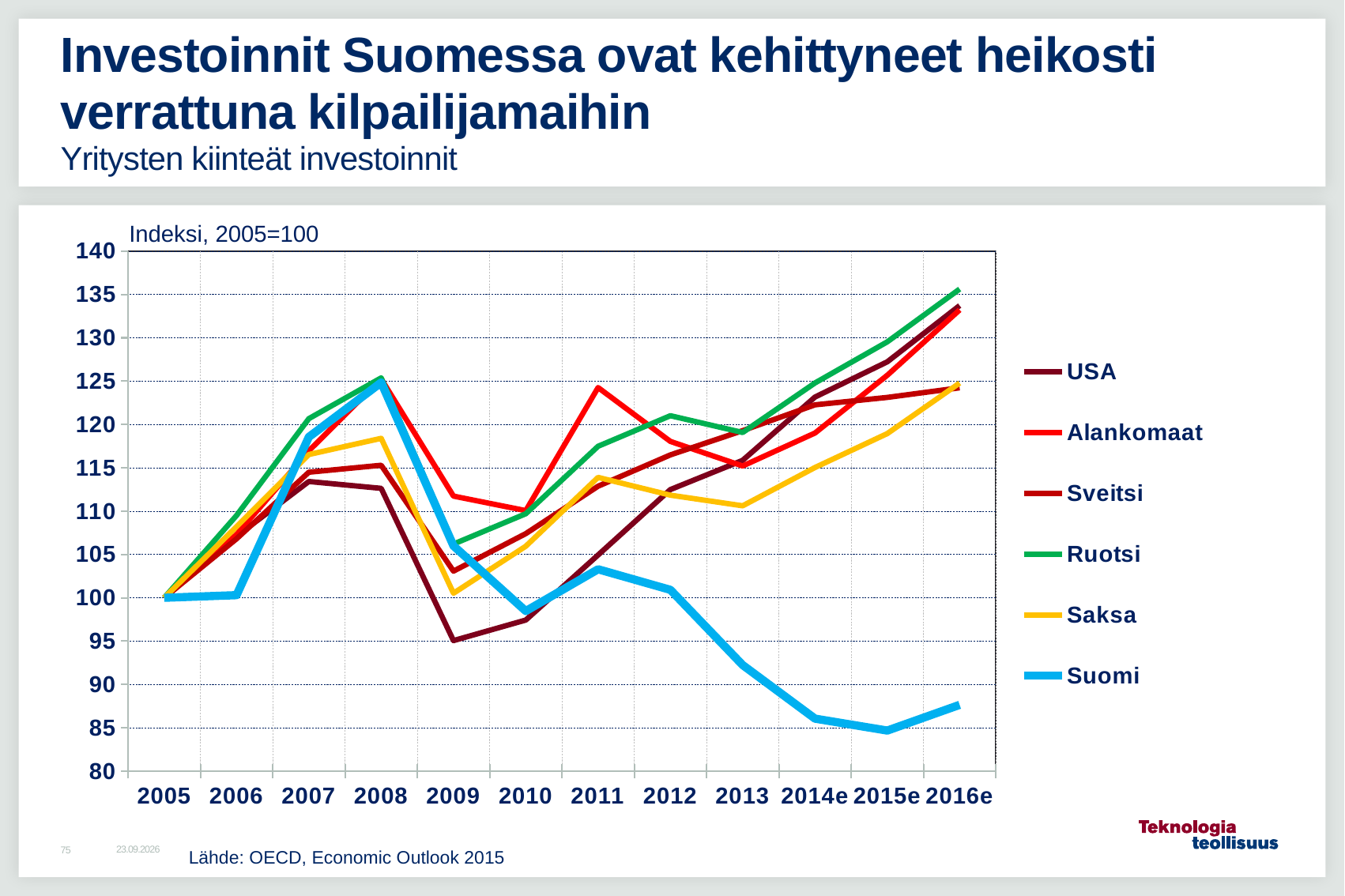
Which country has the highest index value in 2011? Alankomaat Is the value for Suomi in 2016e greater or less than 90? less What is the index value for Suomi in 2005? 100 Which country has the lowest index value in 2009? USA Which country has the lowest index value in 2016e? Suomi Does the Suomi line rise or fall from 2011 to 2015e? fall Which country has the highest index value in 2016e? Ruotsi How many series does the legend list? 6 Is the value for Alankomaat in 2011 greater or less than 120? greater Which colour is used for the Suomi line in the legend? light blue How many years are shown on the x axis? 12 What kind of chart is shown on the slide? line chart